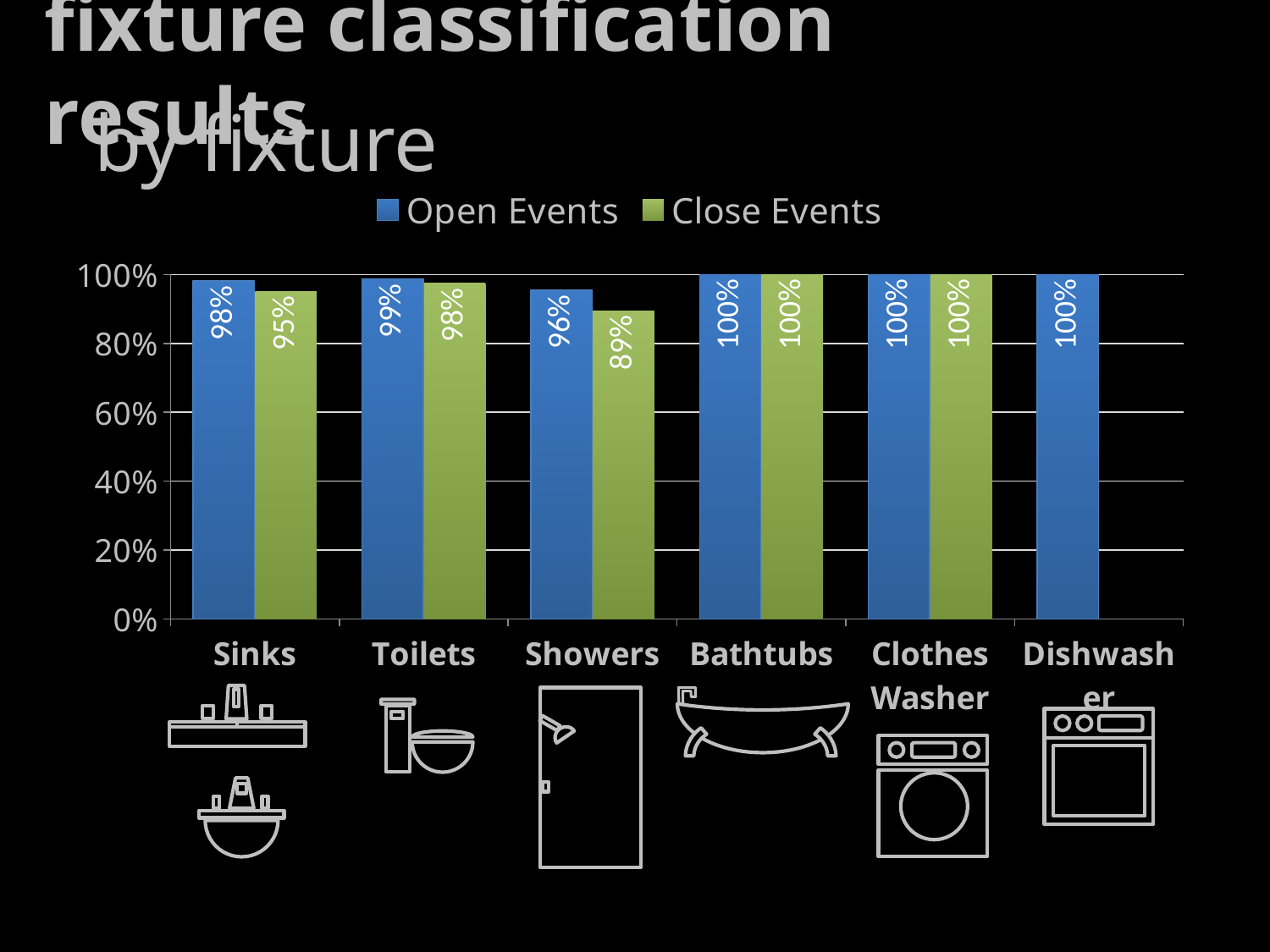
How many series does the legend list? 2 What is the Open Events value for Dishwasher? 100% What is the Close Events value for Toilets? 98% Which fixture has the lowest Open Events value? Showers What kind of chart is shown on the slide? Bar chart What is the Open Events value for Sinks? 98% Which is larger for Sinks, the Open Events value or the Close Events value? Open Events What is the Close Events value for Showers? 89% What is the difference between the Open Events and Close Events values for Showers? 7% What is the difference between the Open Events values for Toilets and Sinks? 1% How many fixture categories are shown on the x axis? 6 Which fixture has the lowest Close Events value? Showers